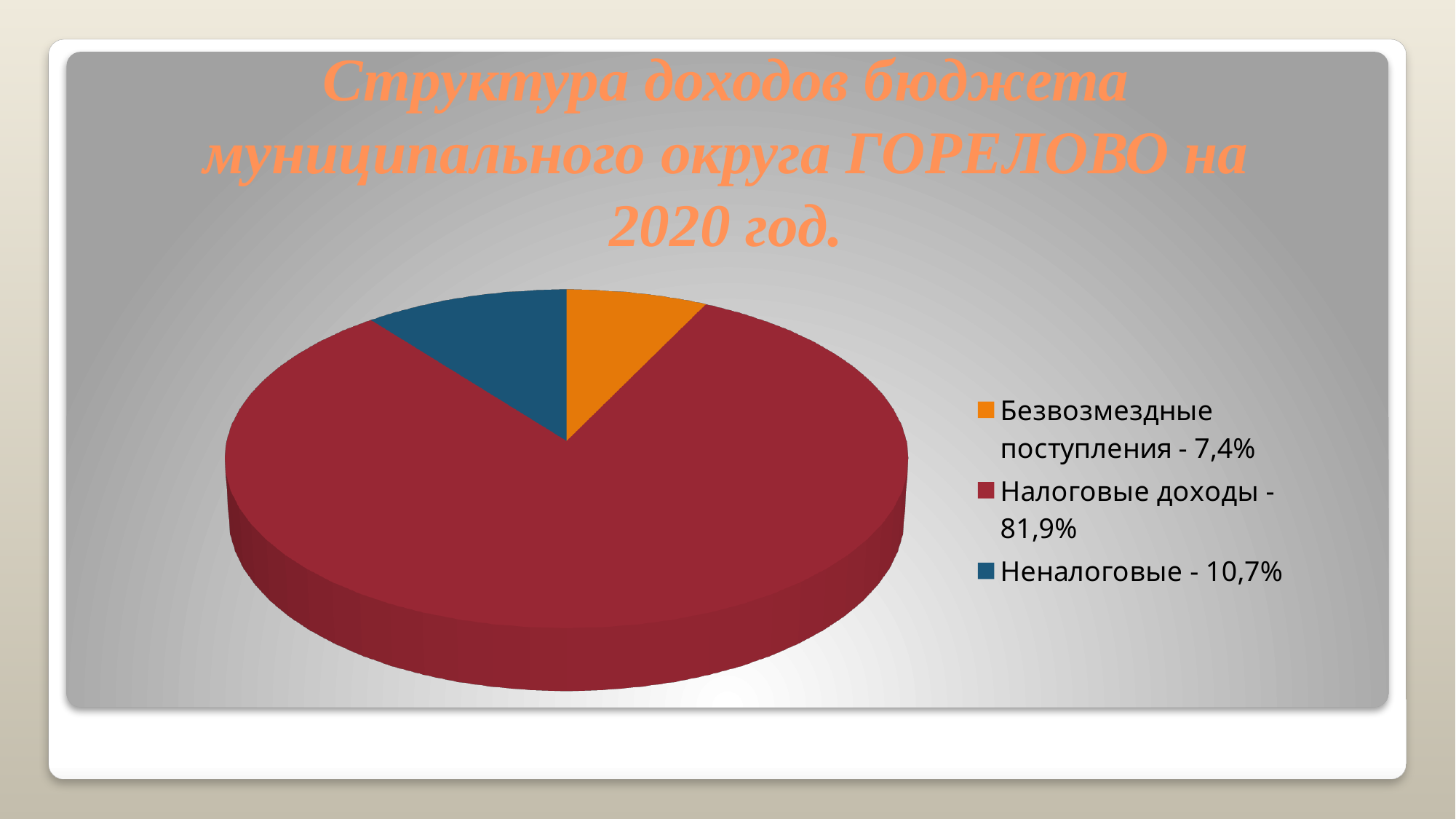
Which category has the largest share of the pie? Налоговые доходы What colour is the slice for Неналоговые? blue What kind of chart is shown on the slide? pie chart Which category has the smallest share of the pie? Безвозмездные поступления What share of the pie is Неналоговые? 10,7% Which is larger: the share of Неналоговые or the share of Безвозмездные поступления? Неналоговые How many categories does the pie chart show? 3 What share of the pie is Налоговые доходы? 81,9% What is the difference between the shares of Налоговые доходы and Неналоговые? 71,2% How many entries does the legend list? 3 What is the difference between the shares of Неналоговые and Безвозмездные поступления? 3,3% What share of the pie is Безвозмездные поступления? 7,4%